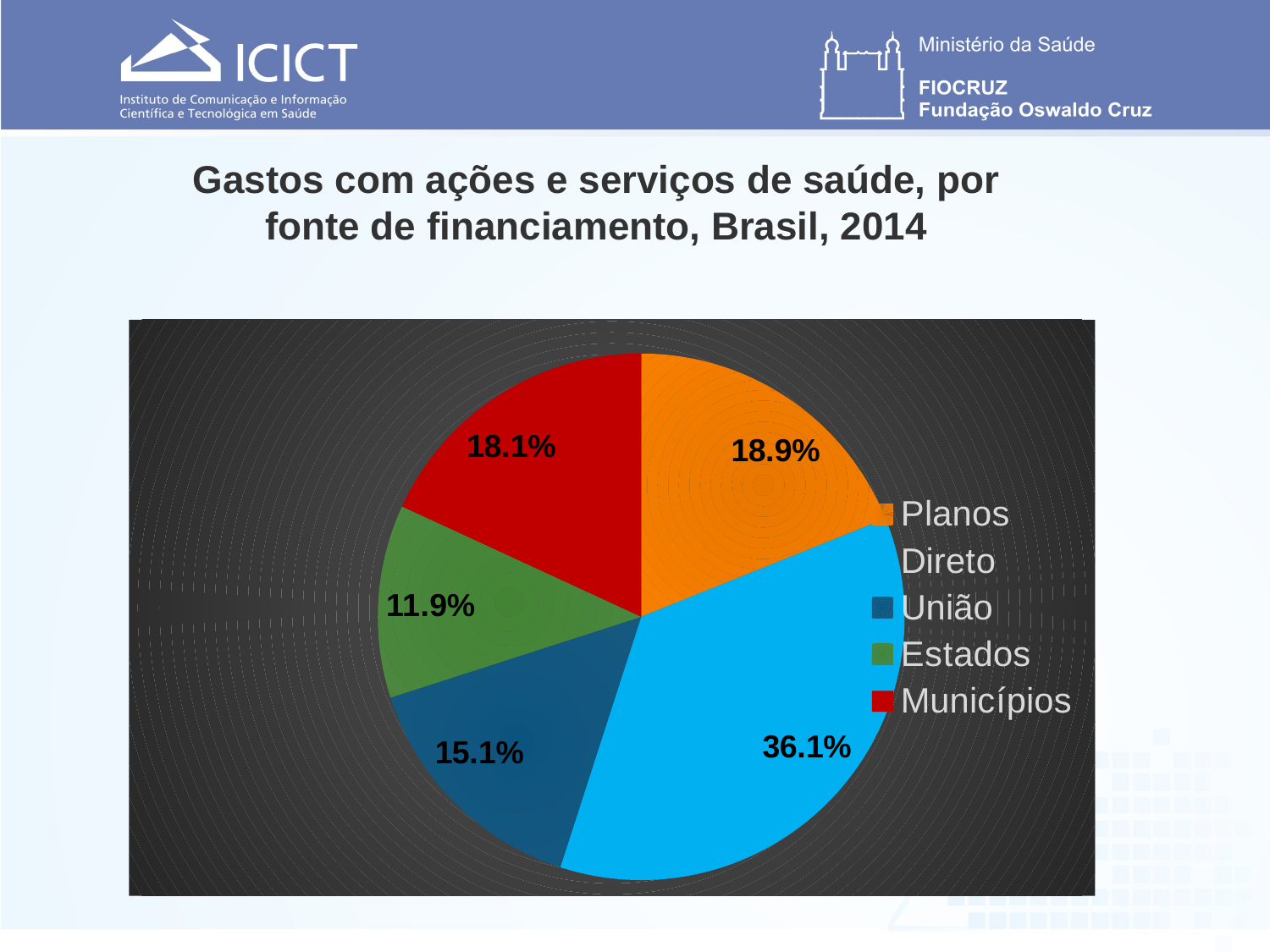
Which funding source has the smallest slice of the pie? Estados Which colour represents União in the pie chart? Dark blue What kind of chart is shown on the slide? Pie chart How many slices does the pie chart have? 5 Which is larger, the share for Planos or the share for Municípios? Planos What is the value for Municípios? 18.1% What share of the pie does Direto account for? 36.1% What percentage is shown for Estados? 11.9% What is the difference between the shares of Direto and União? 21.0% What is the value shown for Planos? 18.9% Which funding source has the largest slice of the pie? Direto How many entries does the legend list? 5